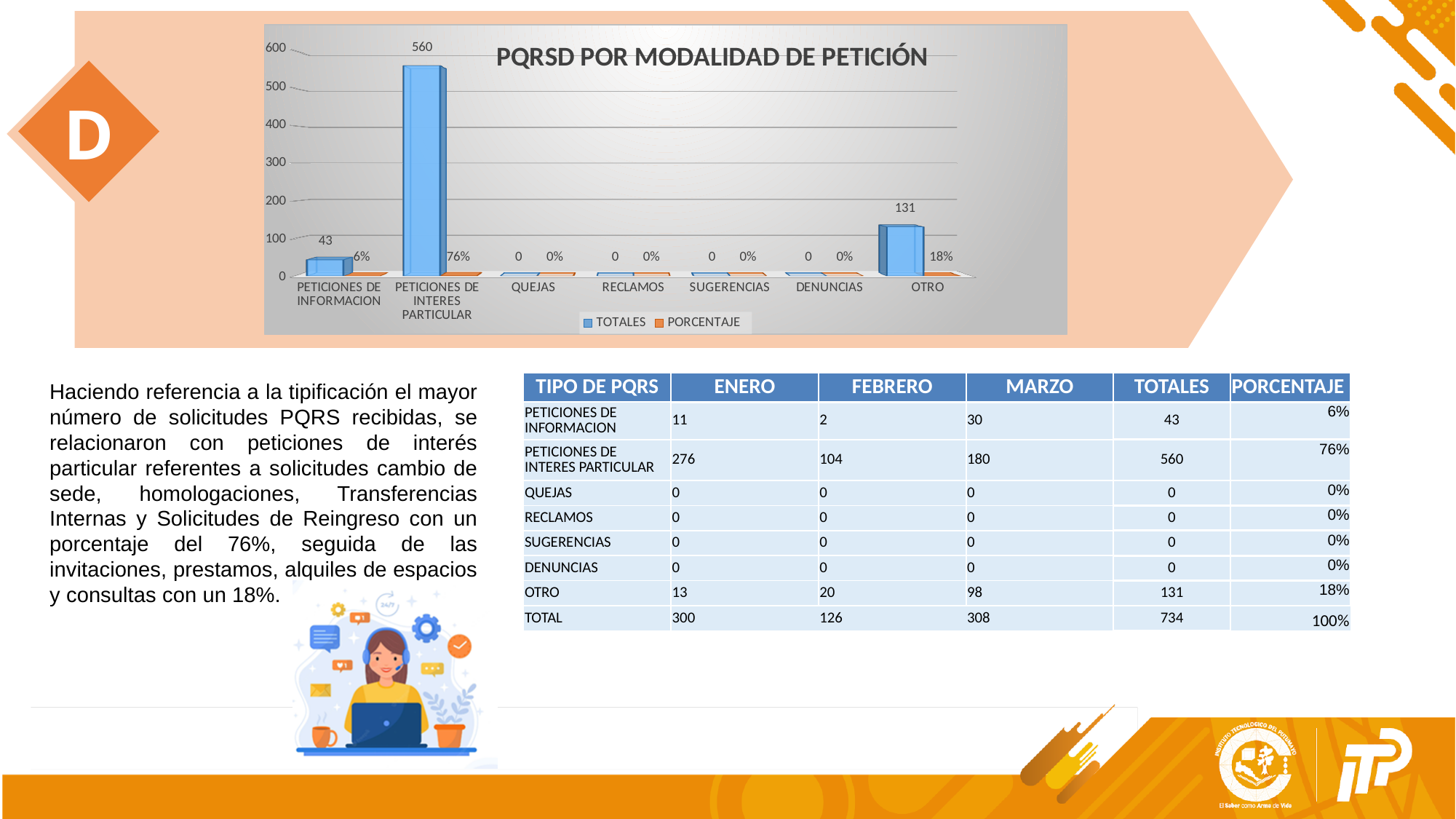
What is the PORCENTAJE value for OTRO? 18% Which category has the highest TOTALES value? PETICIONES DE INTERES PARTICULAR What kind of chart is shown on the slide? bar chart What is the TOTALES value for OTRO? 131 What is the title of the chart? PQRSD POR MODALIDAD DE PETICIÓN Which has a larger TOTALES value, PETICIONES DE INFORMACION or OTRO? OTRO How many categories are shown on the x axis of the chart? 7 What is the PORCENTAJE value for PETICIONES DE INFORMACION? 6% What is the difference in TOTALES between PETICIONES DE INTERES PARTICULAR and OTRO? 429 What is the TOTALES value for PETICIONES DE INTERES PARTICULAR? 560 Is the TOTALES value for PETICIONES DE INTERES PARTICULAR greater or less than 500? greater How many series does the chart legend list? 2